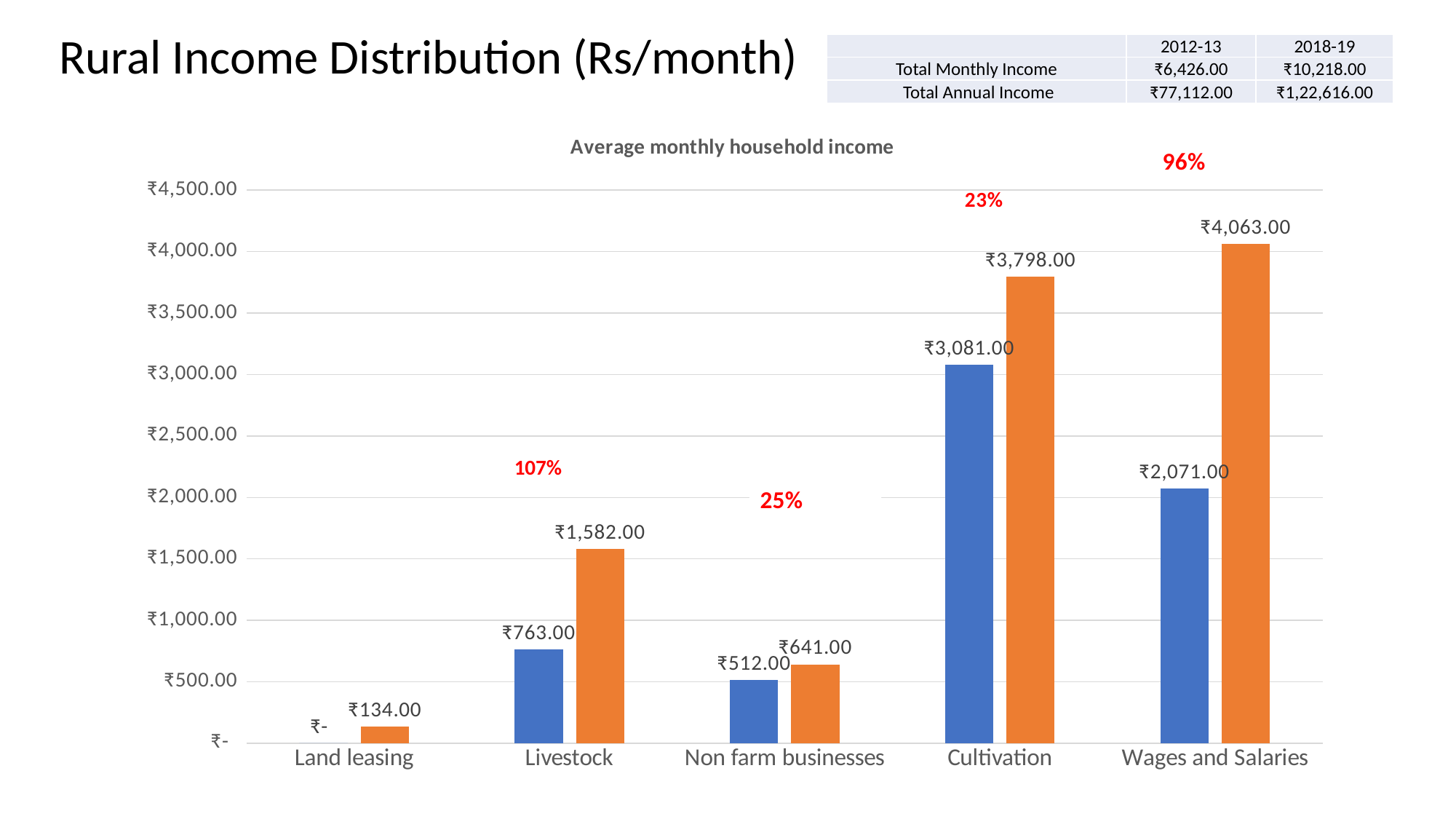
What is the title of the chart? Average monthly household income What is the value of the orange bar for Land leasing? ₹134.00 What red percentage label is shown above the Livestock bars? 107% How many categories are shown on the x axis? 5 Which is larger: the blue bar for Cultivation or the blue bar for Wages and Salaries? Cultivation Which category has the highest orange bar? Wages and Salaries Which category has the lowest blue bar? Land leasing What is the value of the blue bar for Cultivation? ₹3,081.00 What is the value of the blue bar for Non farm businesses? ₹512.00 What kind of chart is shown on the slide? Bar chart What is the value of the orange bar for Wages and Salaries? ₹4,063.00 What is the difference between the orange and blue bars for Livestock? ₹819.00